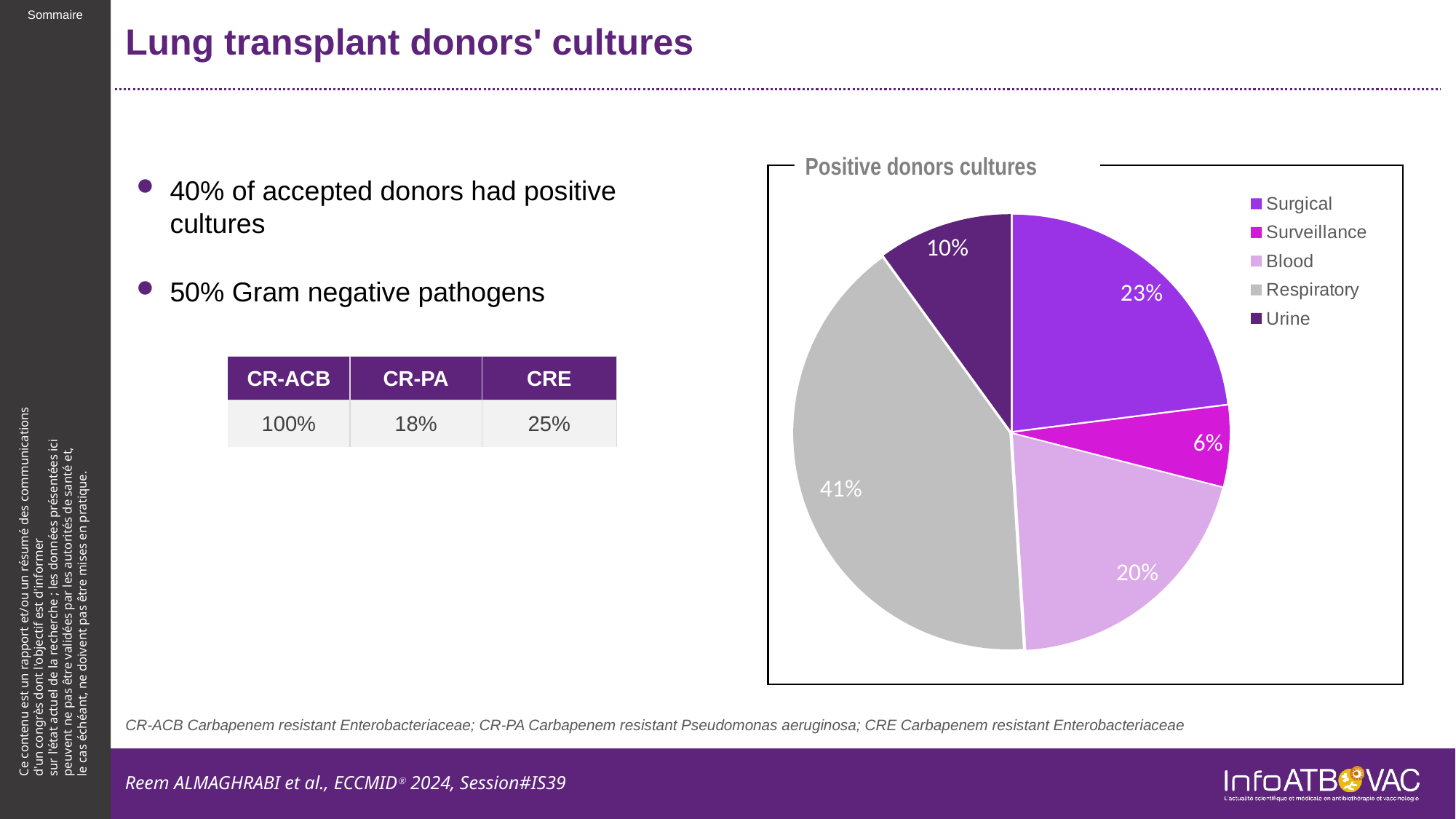
What is the difference in percentage points between Respiratory and Surgical? 18 Which category has the smallest share of positive donor cultures? Surveillance What percentage of positive donor cultures is Urine? 10% What percentage of positive donor cultures is Blood? 20% What type of chart is shown on the slide? Pie chart Which is larger, the Blood share or the Urine share? Blood What is the title of the chart? Positive donors cultures What percentage of positive donor cultures is Surgical? 23% How many categories does the legend list? 5 What percentage of positive donor cultures is Respiratory? 41% What percentage of positive donor cultures is Surveillance? 6% Which category has the largest share of positive donor cultures? Respiratory